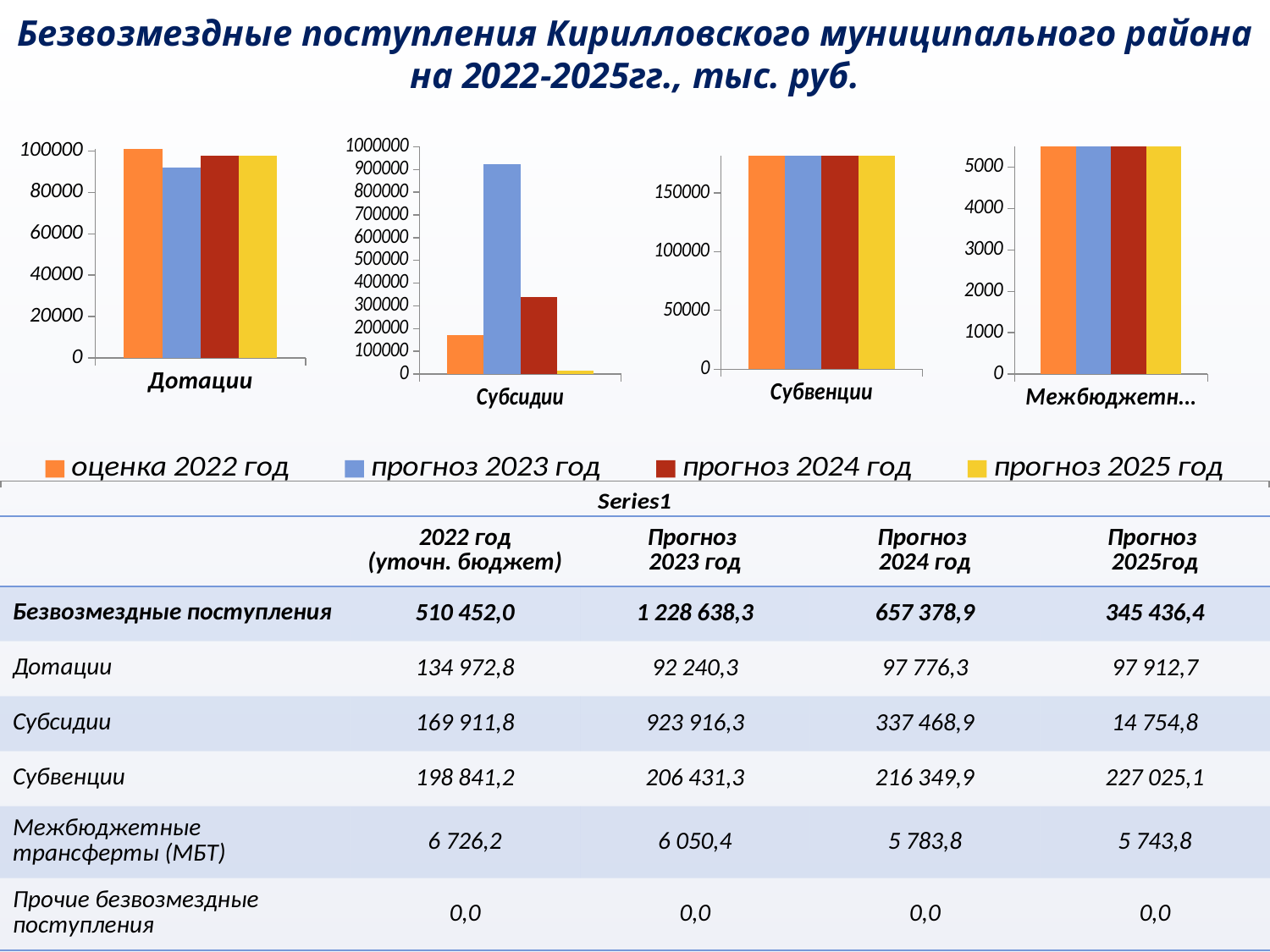
What kind of chart is the Субсидии chart? bar chart In the Субсидии chart, which series has the lowest bar? прогноз 2025 год In the Субвенции chart, is the value for прогноз 2025 год greater or less than 150000? greater In the Субсидии chart, which is larger: прогноз 2024 год or оценка 2022 год? прогноз 2024 год How many bar charts are shown on the slide? 4 In the Дотации chart, which is larger: оценка 2022 год or прогноз 2023 год? оценка 2022 год In the Дотации chart, is the value for прогноз 2023 год greater or less than 100000? less In the Субсидии chart, which series has the highest bar? прогноз 2023 год What colour represents прогноз 2025 год in the legend? yellow How many series does the shared legend below the charts list? 4 In the Субсидии chart, is the value for прогноз 2023 год greater or less than 800000? greater